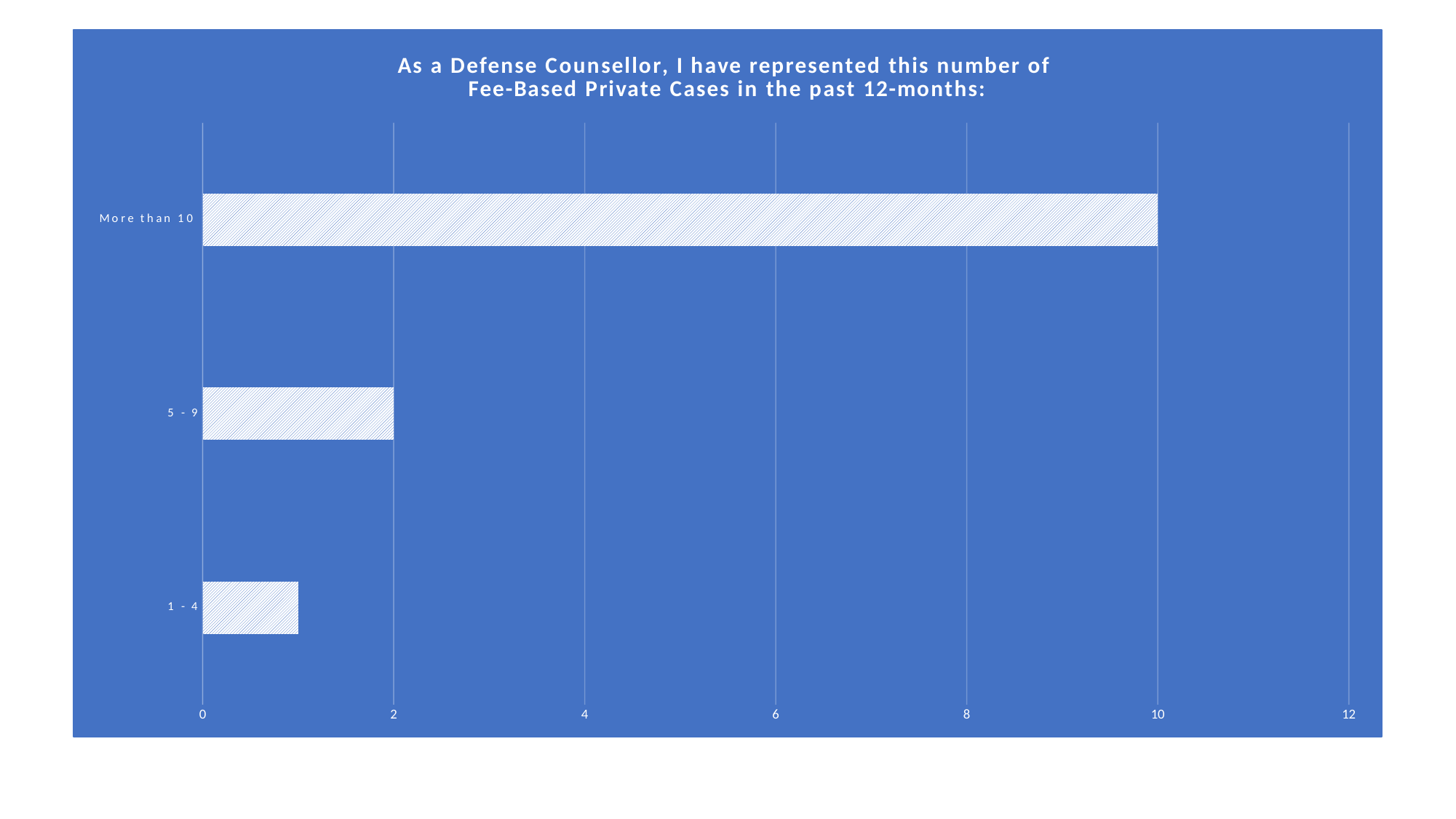
Which has a larger value, "5 - 9" or "1 - 4"? 5 - 9 Which category has the highest value? More than 10 How many categories are plotted in the chart? 3 What is the value for the "5 - 9" category? 2 Is the value for "More than 10" greater or less than 8? greater What is the highest value shown on the horizontal axis? 12 Is the value for "1 - 4" greater or less than 2? less What is the title of the chart? As a Defense Counsellor, I have represented this number of Fee-Based Private Cases in the past 12-months: Which category has the lowest value? 1 - 4 What is the difference between the values for "More than 10" and "5 - 9"? 8 What type of chart is shown on the slide? bar chart What is the value for the "More than 10" category? 10